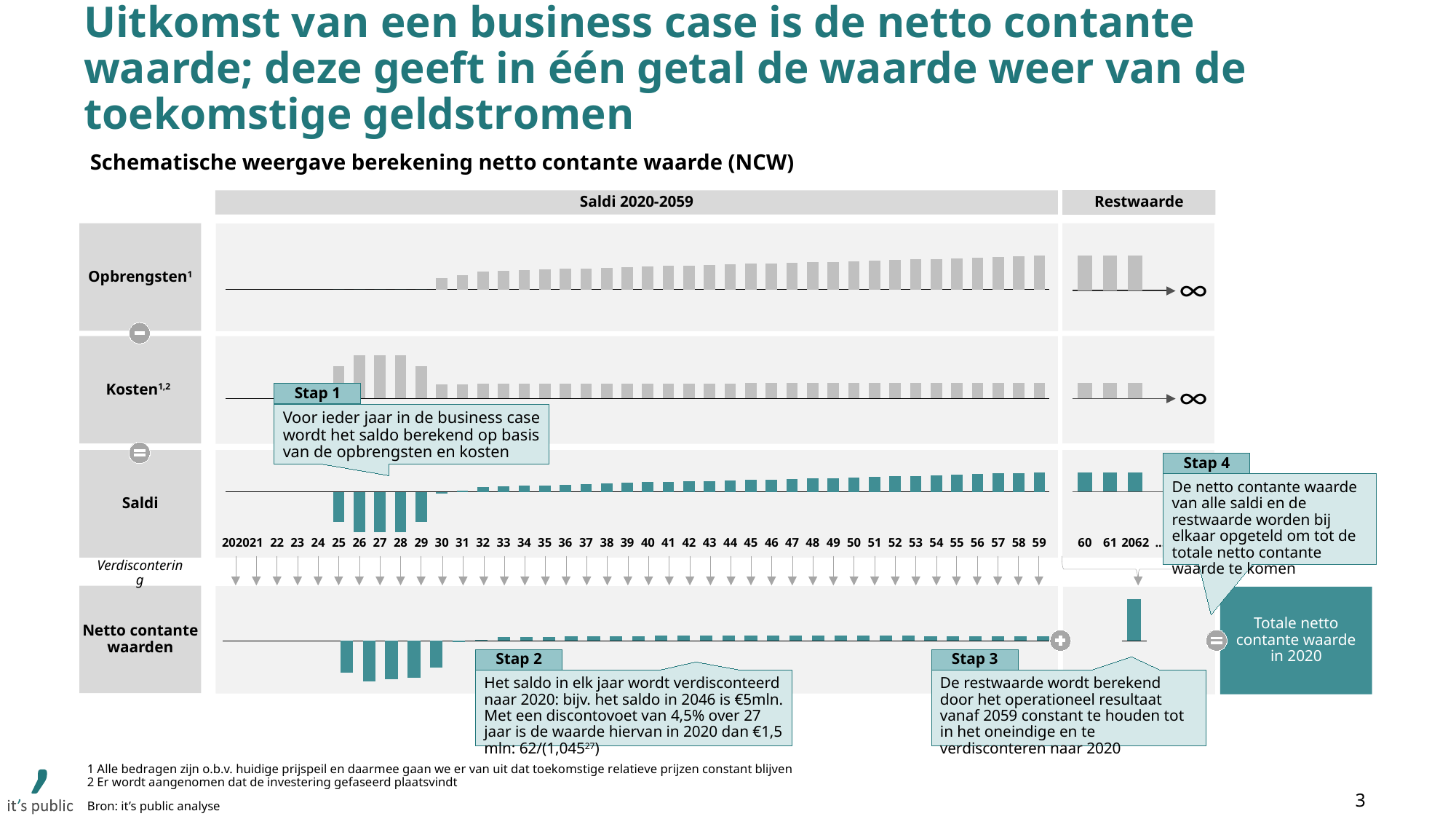
In the 'Saldi' row, is the value for 2050 greater or less than 0? greater In the 'Saldi' row, which is larger: the value for 2059 or the value for 2026? 2059 In the 'Kosten' row, do the bars rise or fall from 2028 to 2030? fall What is the title of the schematic shown on the slide? Schematische weergave berekening netto contante waarde (NCW) What kind of chart is used in the 'Opbrengsten' row of the schematic? bar chart In the 'Netto contante waarden' row, is the value for 2027 greater or less than 0? less In the 'Saldi' row, do the bars rise or fall from 2032 to 2059? rise How many rows of bar charts (Opbrengsten, Kosten, Saldi, Netto contante waarden) does the schematic contain? 4 Which years does the 'Saldi' column header of the schematic cover? 2020-2059 In the 'Opbrengsten' row, do the bars rise or fall from 2030 to 2059? rise In the 'Opbrengsten' row, which is larger: the value for 2059 or the value for 2030? 2059 In the 'Saldi' row, is the value for 2026 greater or less than 0? less